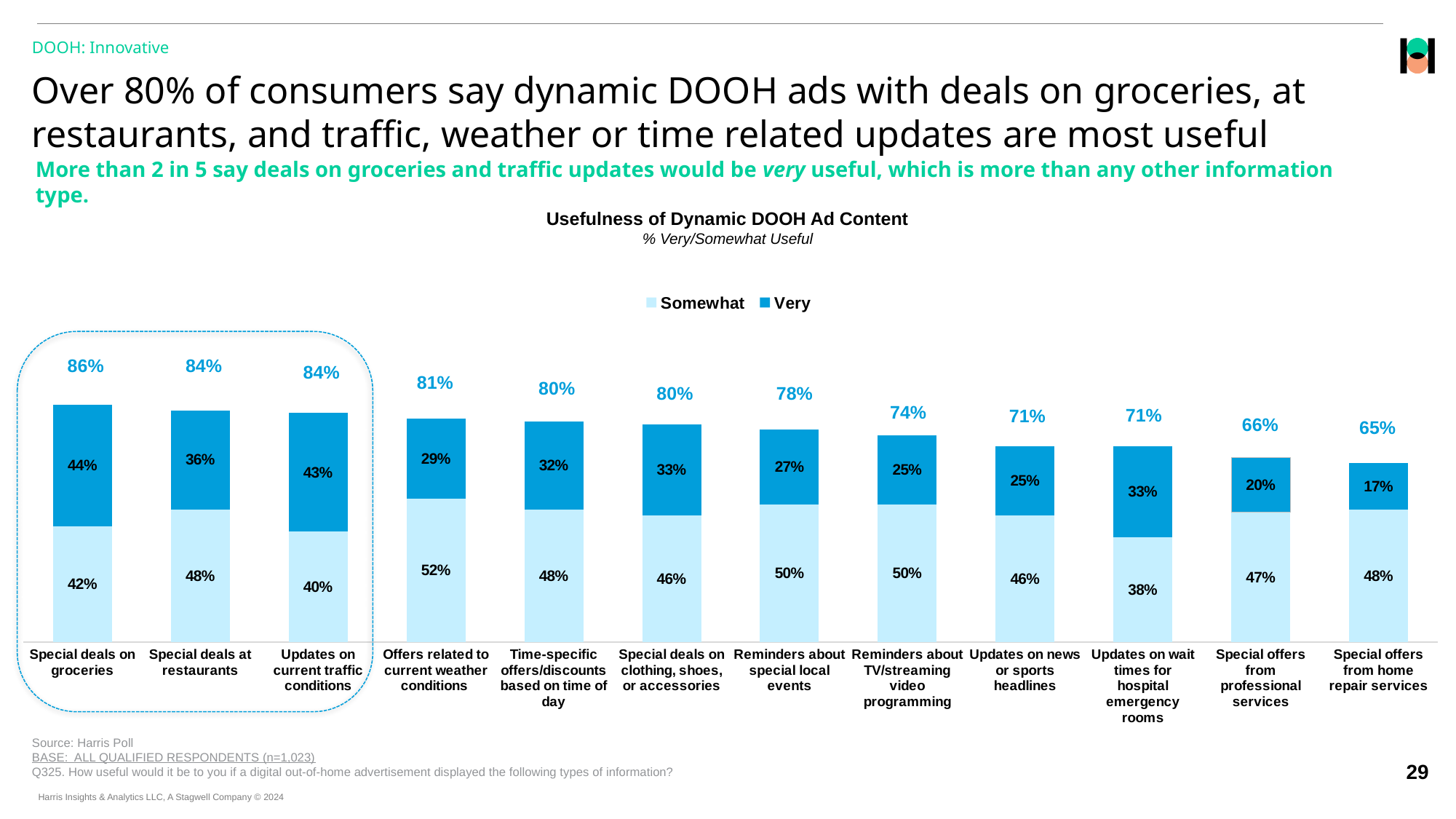
What kind of chart is shown? Stacked bar chart Which category has the lowest total (Very/Somewhat useful)? Special offers from home repair services Do the total values generally rise or fall moving from left to right along the x axis? Fall What is the 'Somewhat' value for Offers related to current weather conditions? 52% How many categories are shown on the x axis? 12 What is the 'Very' value for Special deals on groceries? 44% What is the difference between the 'Very' values for Special deals on groceries and Special offers from home repair services? 27% How many series does the legend list? 2 Which has a larger 'Very' value: Special deals at restaurants or Updates on wait times for hospital emergency rooms? Special deals at restaurants Which category has the highest total (Very/Somewhat useful)? Special deals on groceries What is the total shown above the bar for Updates on wait times for hospital emergency rooms? 71% What is the title of the chart? Usefulness of Dynamic DOOH Ad Content